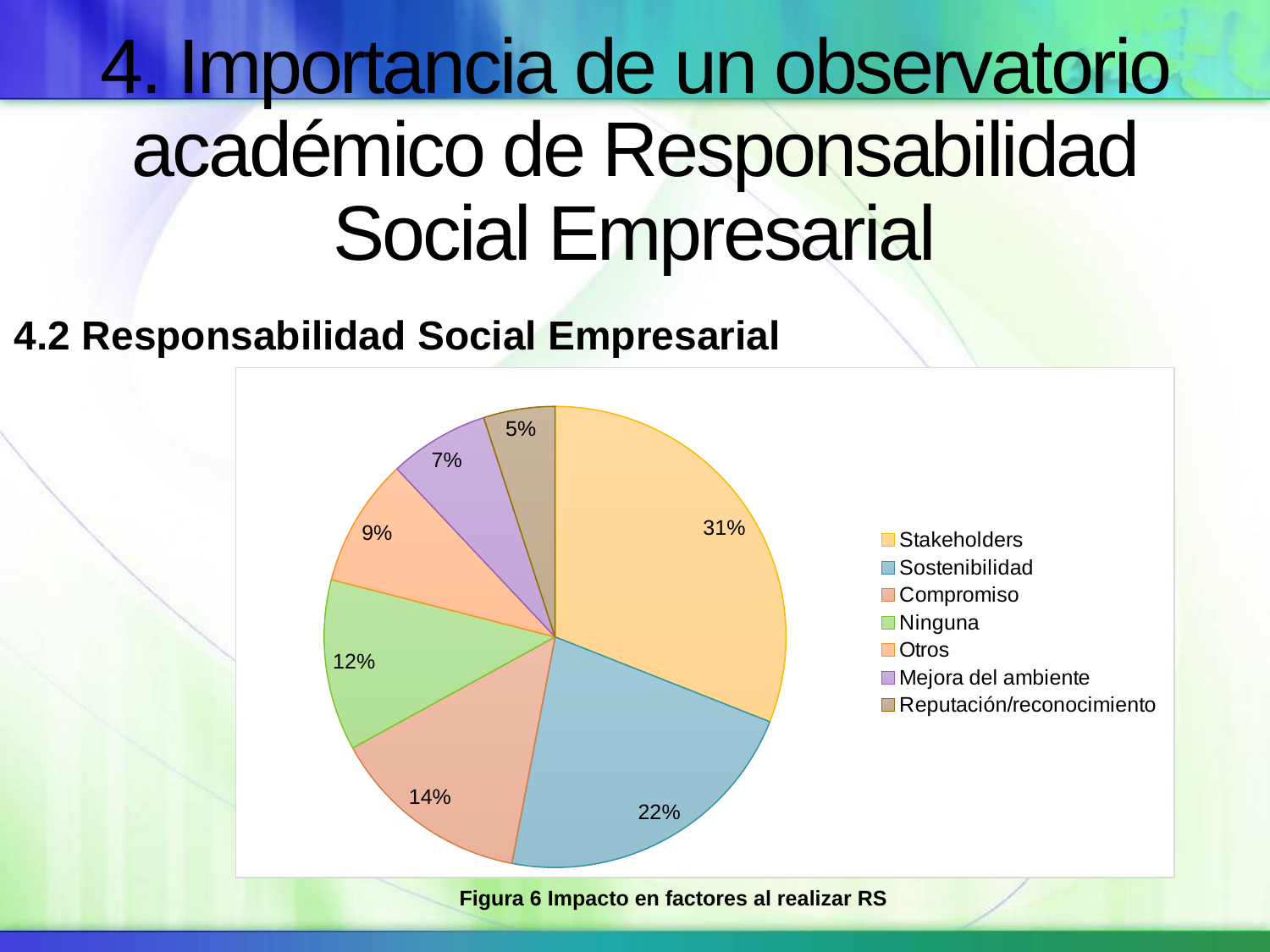
What is the difference between the Stakeholders and Sostenibilidad shares? 9% Which category has the smallest slice of the pie? Reputación/reconocimiento What is the value for Mejora del ambiente? 7% How many categories does the pie chart show? 7 What percentage is shown for Sostenibilidad? 22% Which is larger, the Otros slice or the Ninguna slice? Ninguna What is the caption below the chart? Figura 6 Impacto en factores al realizar RS Which category has the largest slice of the pie? Stakeholders What is the value for Compromiso? 14% What type of chart is shown on the slide? Pie chart What percentage does the Ninguna slice show? 12% What share of the pie does Stakeholders have? 31%